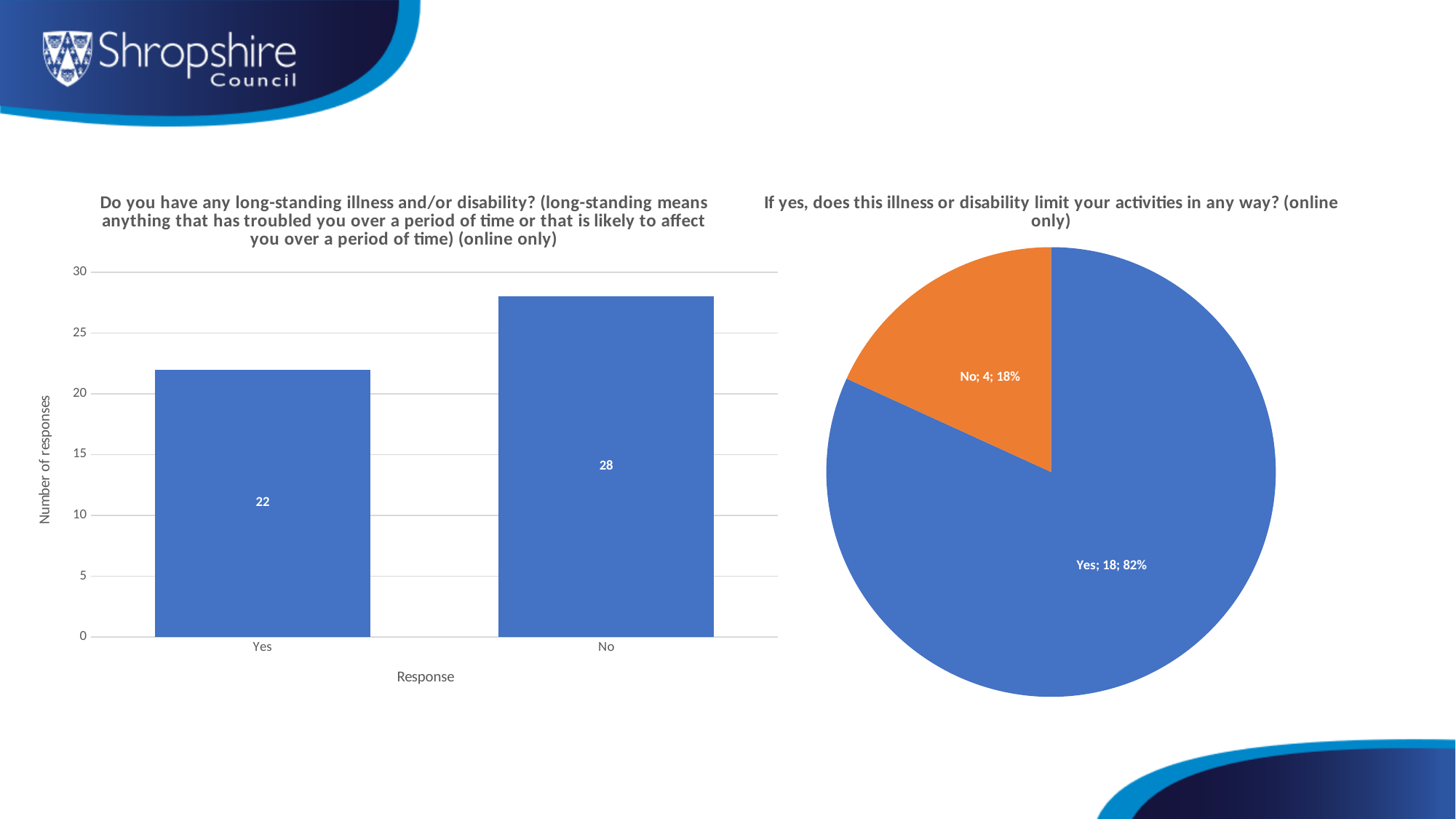
In the right chart (does this illness or disability limit your activities), which slice is the smallest? No In the left chart (long-standing illness and/or disability), how many responses were 'No'? 28 In the left chart (long-standing illness and/or disability), is the value for 'Yes' greater or less than 25? less In the right chart (does this illness or disability limit your activities), what percentage of responses were 'Yes'? 82% In the left chart (long-standing illness and/or disability), how many responses were 'Yes'? 22 In the left chart (long-standing illness and/or disability), what is the difference between the 'No' and 'Yes' response counts? 6 What kind of chart is the right chart (does this illness or disability limit your activities)? Pie chart In the right chart (does this illness or disability limit your activities), how many responses were 'No'? 4 What kind of chart is the left chart (long-standing illness and/or disability)? Bar chart In the left chart (long-standing illness and/or disability), which response has the higher number of responses? No What is the y-axis label of the left chart (long-standing illness and/or disability)? Number of responses How many categories are shown on the x axis of the left chart (long-standing illness and/or disability)? 2